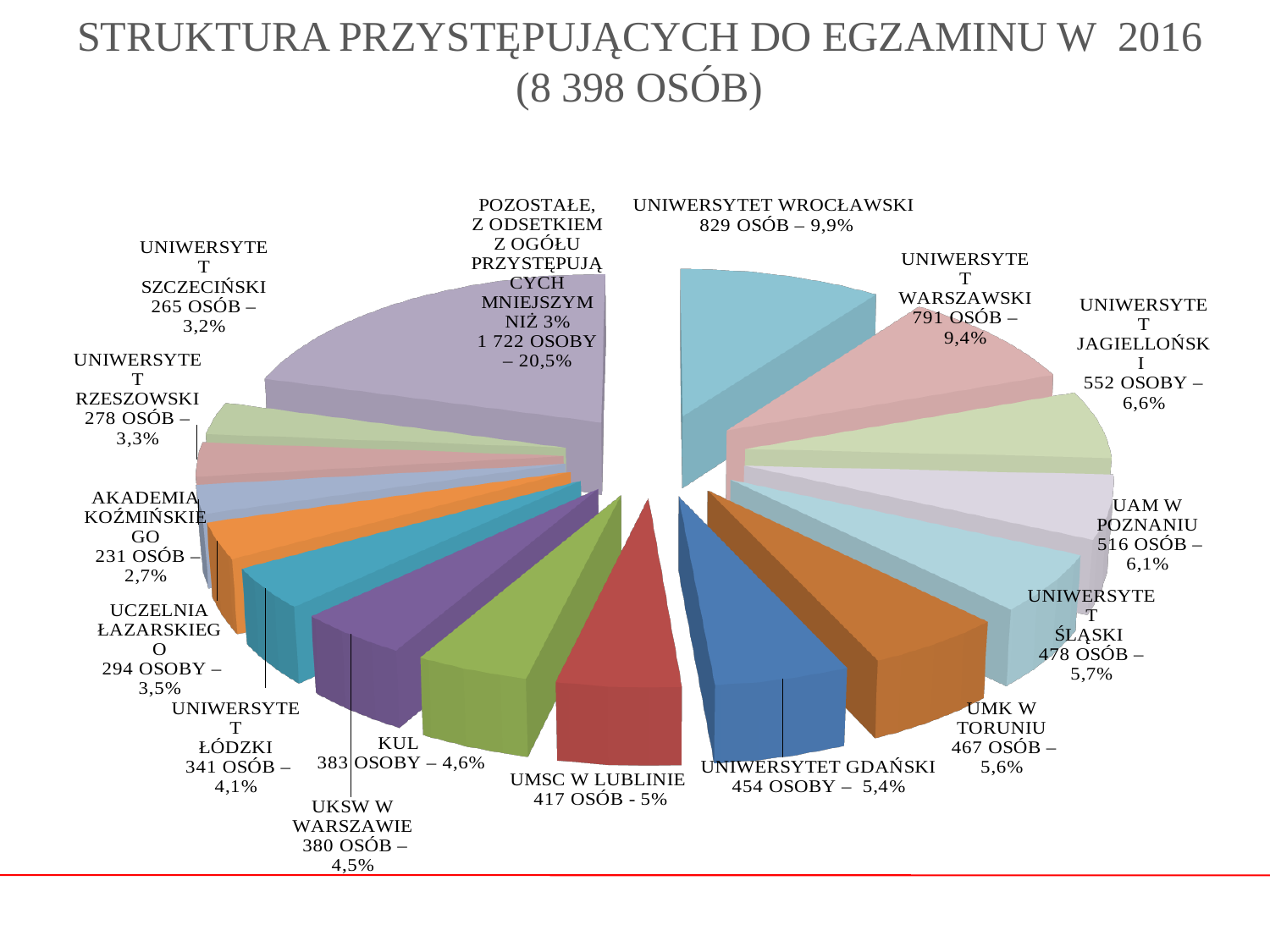
How many slices does the pie chart have? 16 What is the difference in the number of people between Uniwersytet Wrocławski and Uniwersytet Warszawski? 38 Which individually named university has the smallest slice in the pie chart? Akademia Koźmińskiego What percentage share does UMSC w Lublinie have? 5% How many people does the KUL slice represent? 383 Which slice of the pie chart is the largest? Pozostałe (20,5%) What kind of chart is shown on the slide? pie chart How many people does the 'Pozostałe' (remaining, each below 3%) slice represent? 1 722 What percentage share does Uniwersytet Warszawski have in the pie chart? 9,4% Which has more exam takers: UMK w Toruniu or Uniwersytet Gdański? UMK w Toruniu According to the slide title, how many people in total took the exam in 2016? 8 398 How many people from Uniwersytet Wrocławski took the exam in 2016? 829